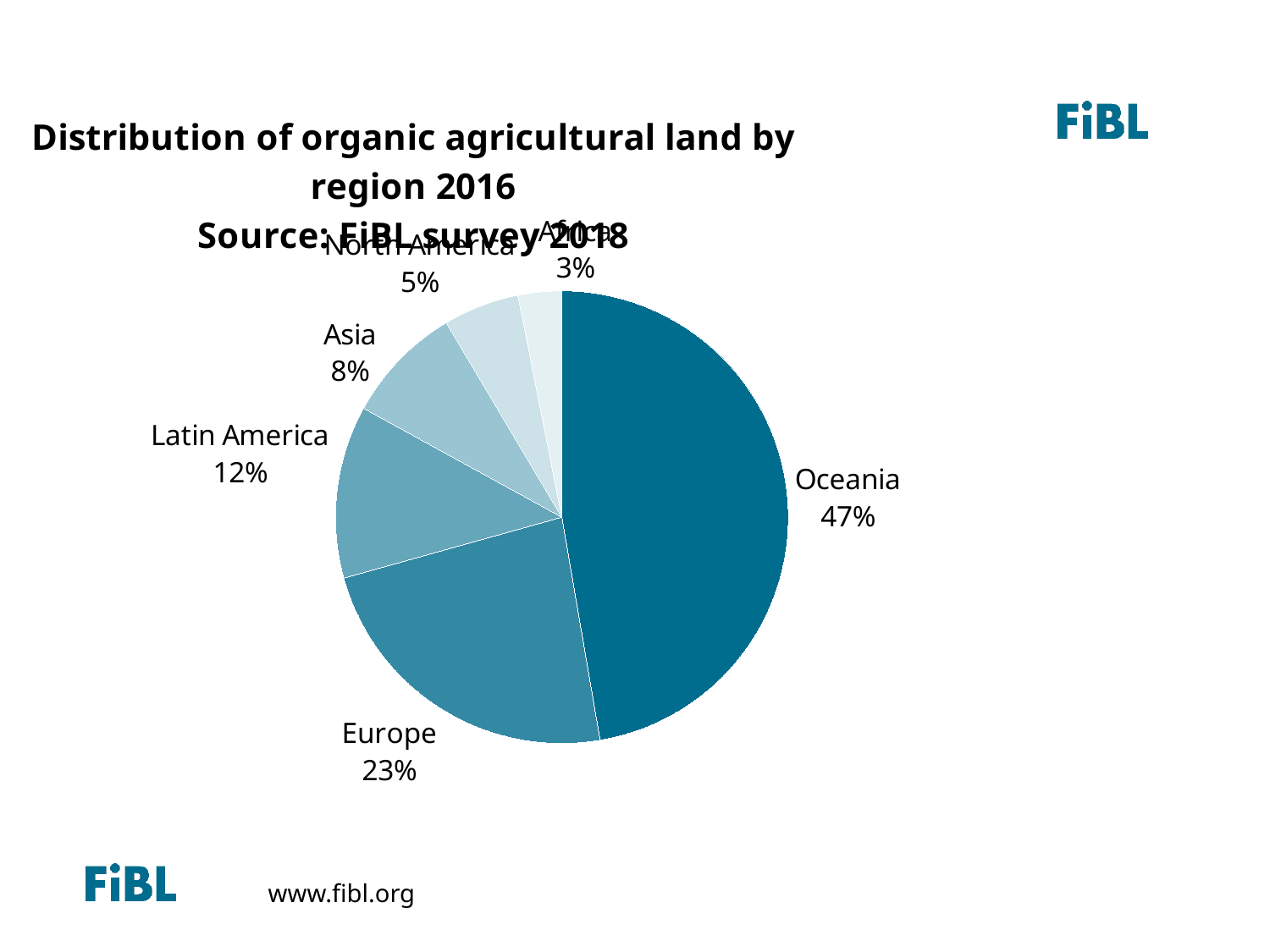
What is the title of the chart? Distribution of organic agricultural land by region 2016 What share of organic agricultural land does Oceania hold? 47% How many regions are shown in the pie chart? 6 How many percentage points larger is Oceania's share than Europe's share? 24 What share of organic agricultural land does Asia hold? 8% What share of organic agricultural land does Latin America hold? 12% What type of chart is shown on the slide? pie chart What share of organic agricultural land does North America hold? 5% Which region has the smallest share of organic agricultural land? Africa Which region has the largest share of organic agricultural land? Oceania What share of organic agricultural land does Europe hold? 23% Which region has a larger share, Latin America or Asia? Latin America